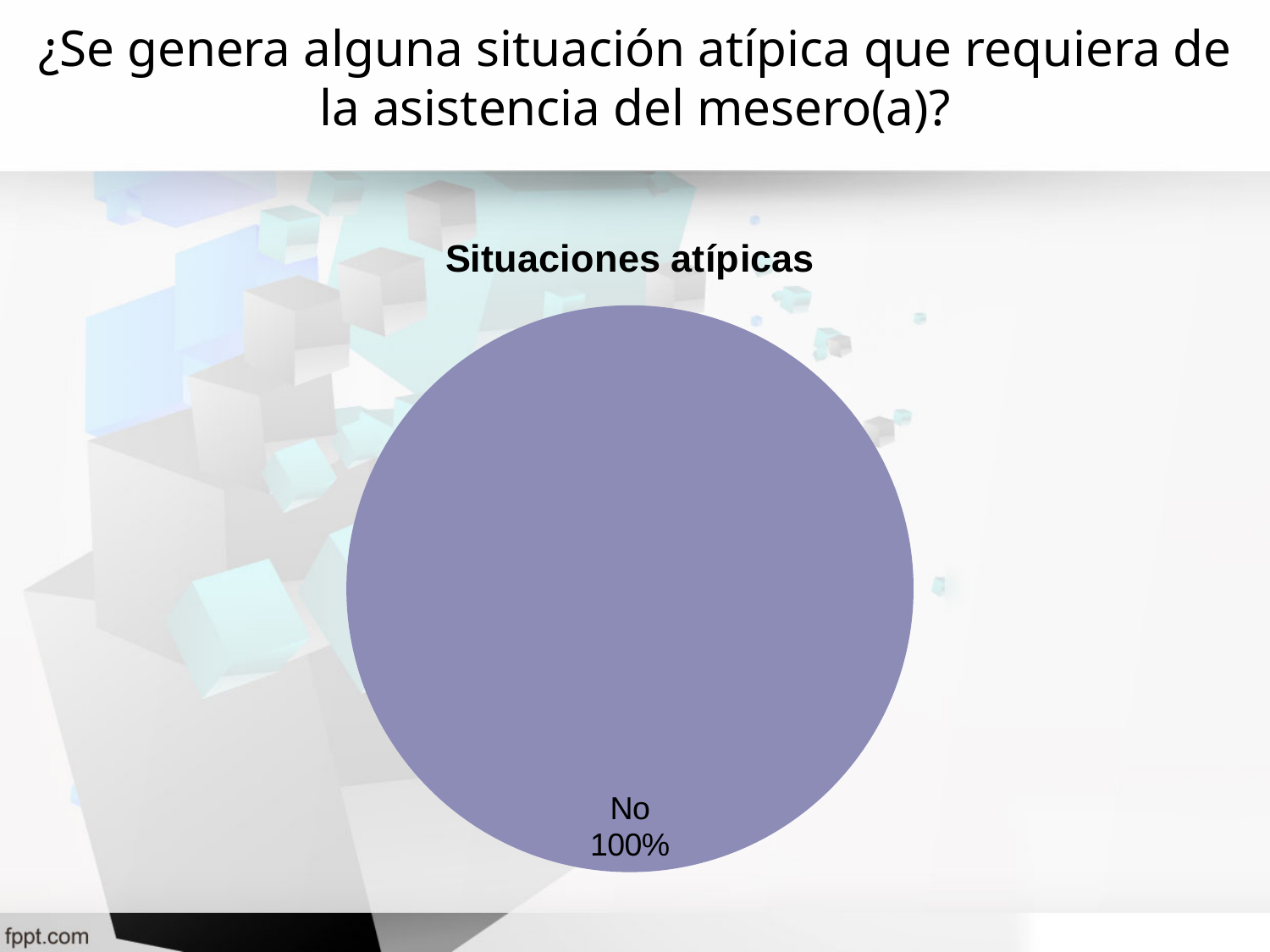
Is the value for "No" greater or less than 50%? greater What is the value labelled for the "No" category? 100% What is the title of the chart? Situaciones atípicas How many slices are shown in the pie chart? 1 Which category makes up the entire pie chart? No What kind of chart is shown on the slide? pie chart What share of the pie does the "No" slice represent? 100%